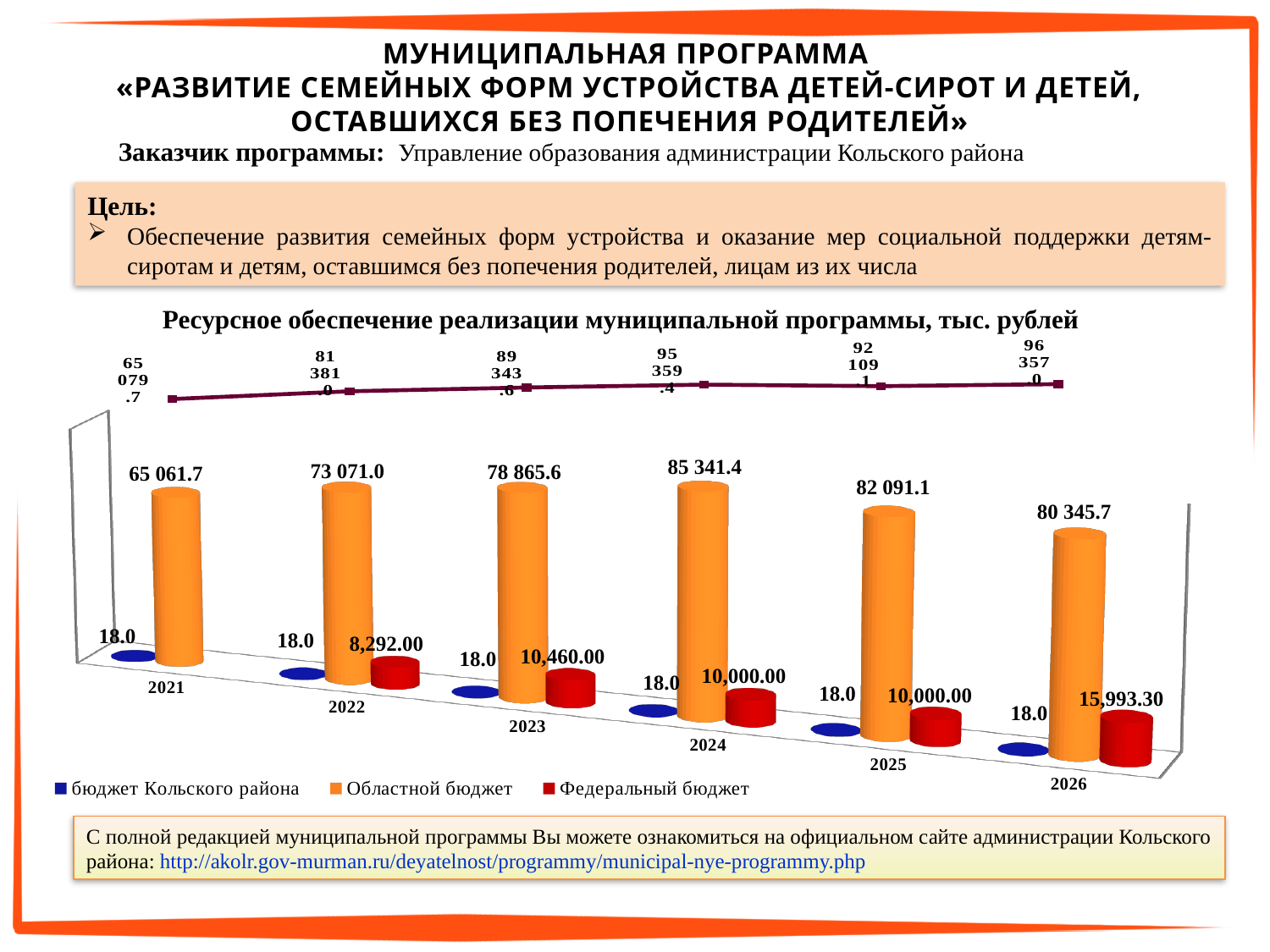
What is the difference between Федеральный бюджет in 2023 and in 2022? 2,168.00 In which year is Областной бюджет highest? 2024 What is the value for Федеральный бюджет in 2022? 8,292.00 What kind of chart is used for the budget values? bar chart What is the title of the chart? Ресурсное обеспечение реализации муниципальной программы, тыс. рублей What is the value for Областной бюджет in 2024? 85 341.4 How many series does the legend list? 3 How many years are shown on the x axis? 6 In which year is Областной бюджет lowest? 2021 Which is larger, Областной бюджет in 2025 or in 2026? 2025 What is the value for Федеральный бюджет in 2026? 15,993.30 What is the value for бюджет Кольского района in 2023? 18.0